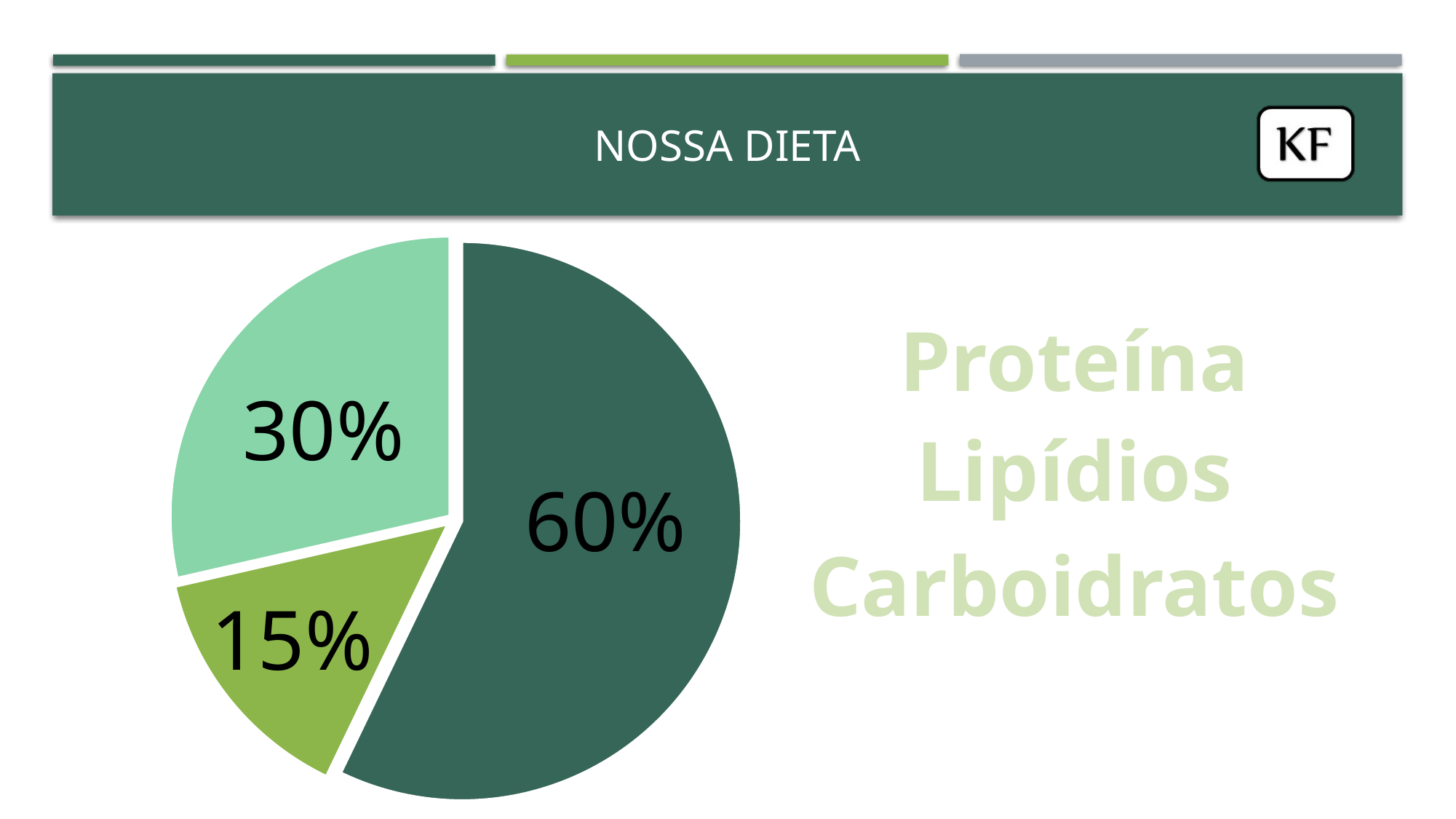
What value is labelled on the lime-green slice of the pie chart? 15% What is the value shown on the smallest slice of the pie chart? 15% What is the value shown on the largest slice of the pie chart? 60% What is the difference between the 30% slice and the 15% slice? 15% Which slice is larger, the dark green one or the lime-green one? the dark green one What is the difference between the 60% slice and the 30% slice? 30% What value is labelled on the dark green slice of the pie chart? 60% What is the title shown in the header bar above the pie chart? NOSSA DIETA What kind of chart is shown on the slide? pie chart What value is labelled on the light mint-green slice of the pie chart? 30% What three words are listed to the right of the pie chart? Proteína, Lipídios, Carboidratos How many slices does the pie chart have? 3